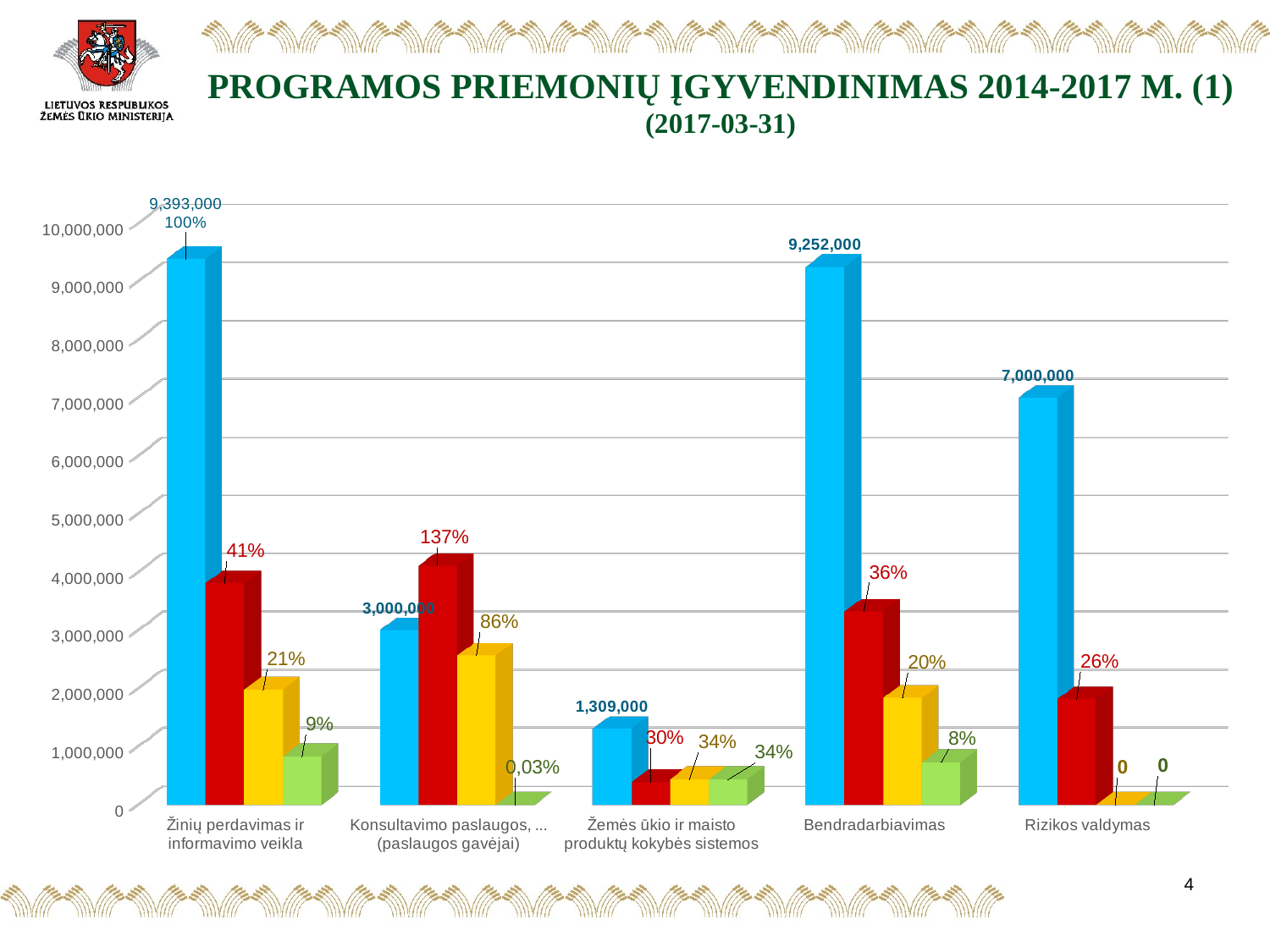
What kind of chart is shown on the slide? bar chart Which has the larger blue bar value, Bendradarbiavimas or Rizikos valdymas? Bendradarbiavimas What is the difference between the blue bar values for Žinių perdavimas ir informavimo veikla and Bendradarbiavimas? 141,000 Which category has the highest blue bar? Žinių perdavimas ir informavimo veikla What value is labelled on the blue bar for Žinių perdavimas ir informavimo veikla? 9,393,000 How many categories are shown on the x axis? 5 Is the value of the red bar for Žinių perdavimas ir informavimo veikla greater or less than 3,000,000? greater What value is labelled on the blue bar for Žemės ūkio ir maisto produktų kokybės sistemos? 1,309,000 What value is labelled on the blue bar for Bendradarbiavimas? 9,252,000 Which category has the lowest blue bar? Žemės ūkio ir maisto produktų kokybės sistemos What percentage is labelled on the red bar for Konsultavimo paslaugos (paslaugos gavėjai)? 137% What value is labelled on the blue bar for Rizikos valdymas? 7,000,000